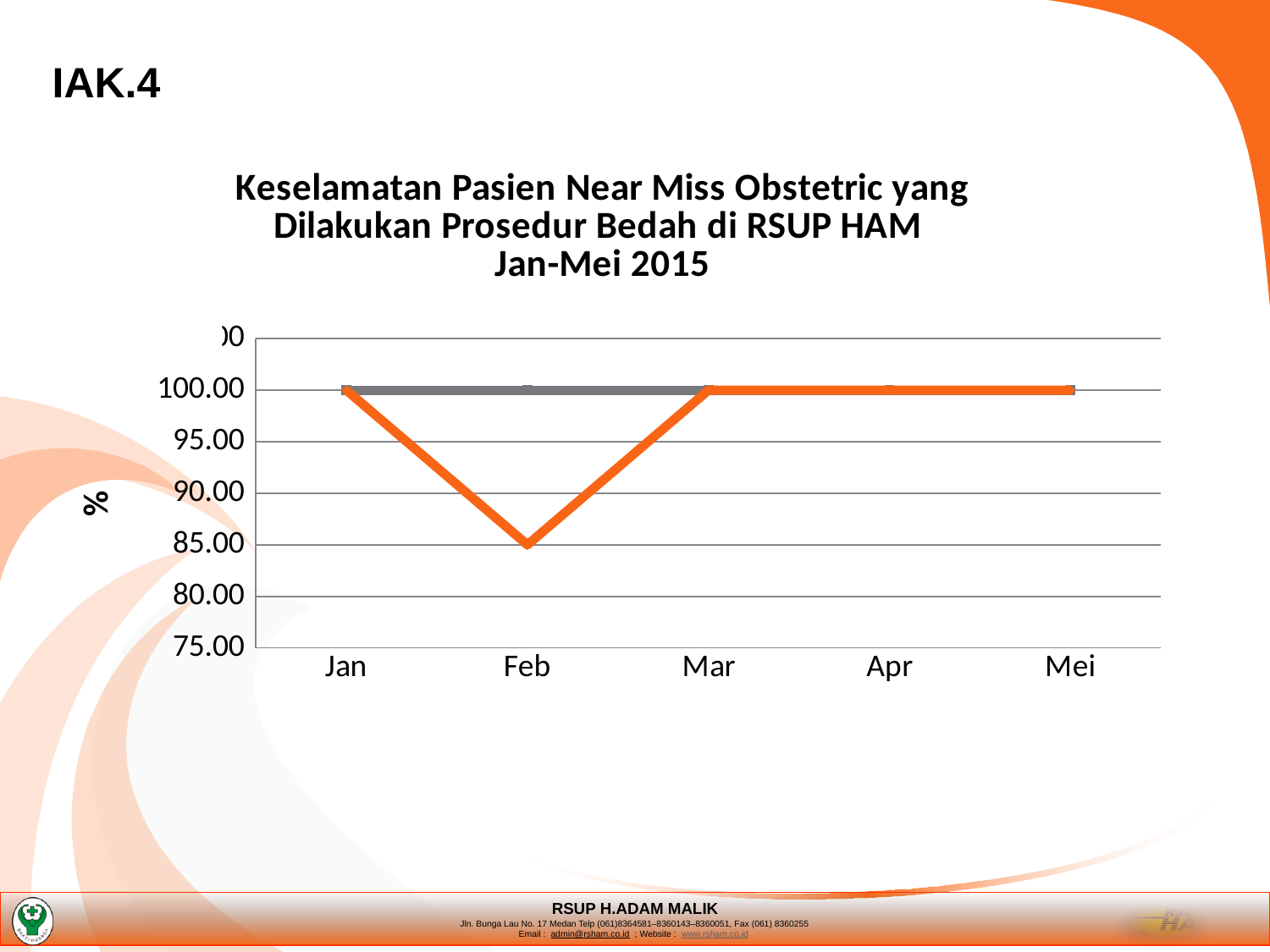
What is the value of the orange line for Jan? 100.00 What is the label on the vertical axis of the chart? % What kind of chart is shown on the slide? line chart What is the difference between the Jan value and the Feb value on the orange line? 15.00 What period does the chart title say the data covers? Jan-Mei 2015 What is the value of the orange line for Mei? 100.00 Is the value for Feb greater or less than 90.00? less Which month has the larger value on the orange line, Jan or Feb? Jan What is the value of the orange line for Feb? 85.00 How many months are shown on the x axis of the chart? 5 Does the orange line rise or fall from Feb to Mar? rise In which month is the orange line at its lowest value? Feb